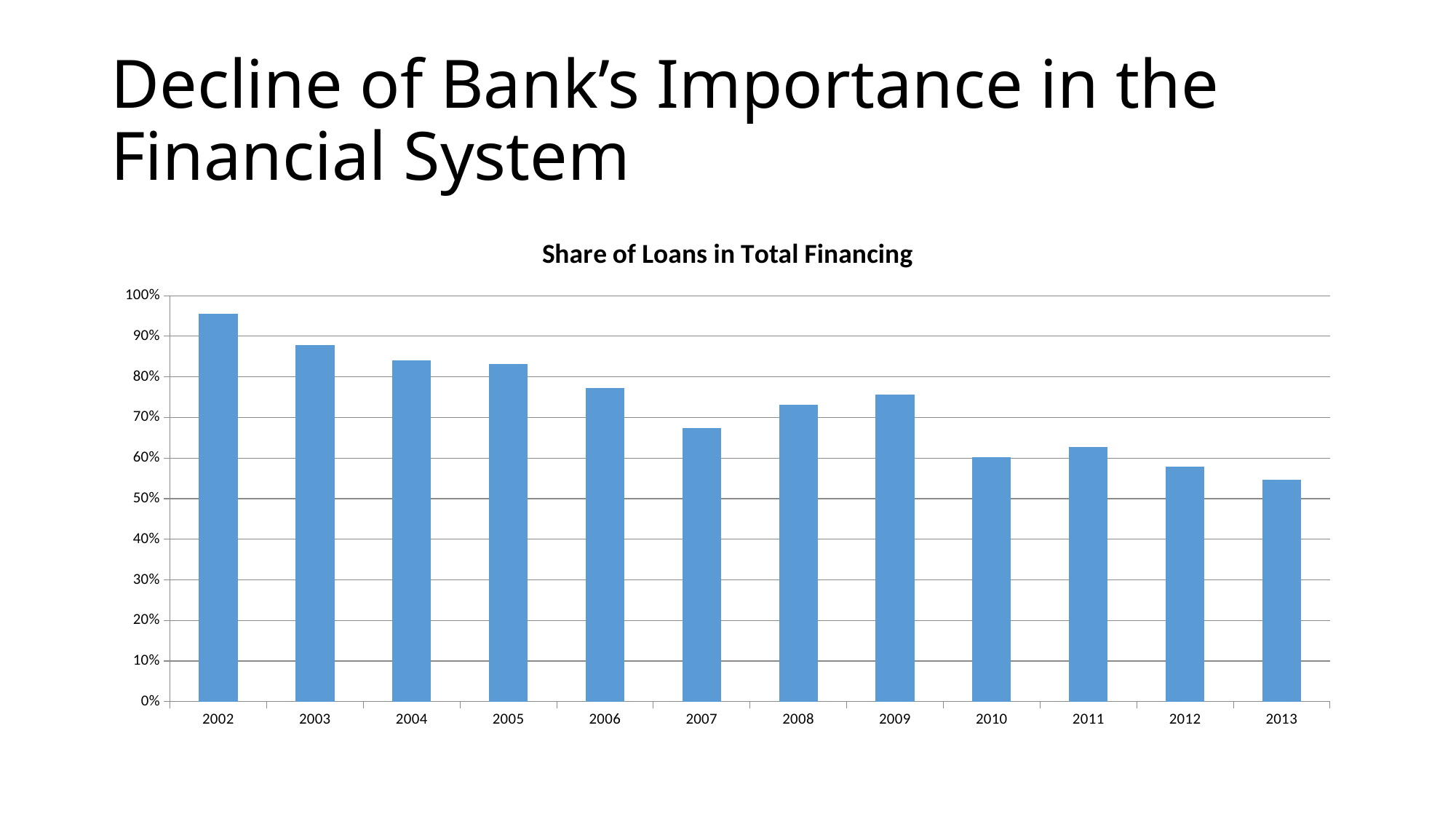
Which year has the highest share of loans in total financing? 2002 Overall, do the values rise or fall from 2002 to 2013? fall Which year has the lowest share of loans in total financing? 2013 Is the value for 2013 greater or less than 50%? greater Is the value for 2002 greater or less than 90%? greater Is the value for 2012 greater or less than 60%? less How many years are shown on the x axis of the chart? 12 Which year has a higher share of loans, 2010 or 2011? 2011 What type of chart is shown on the slide? bar chart What is the title of the chart? Share of Loans in Total Financing Which year has a higher share of loans, 2007 or 2008? 2008